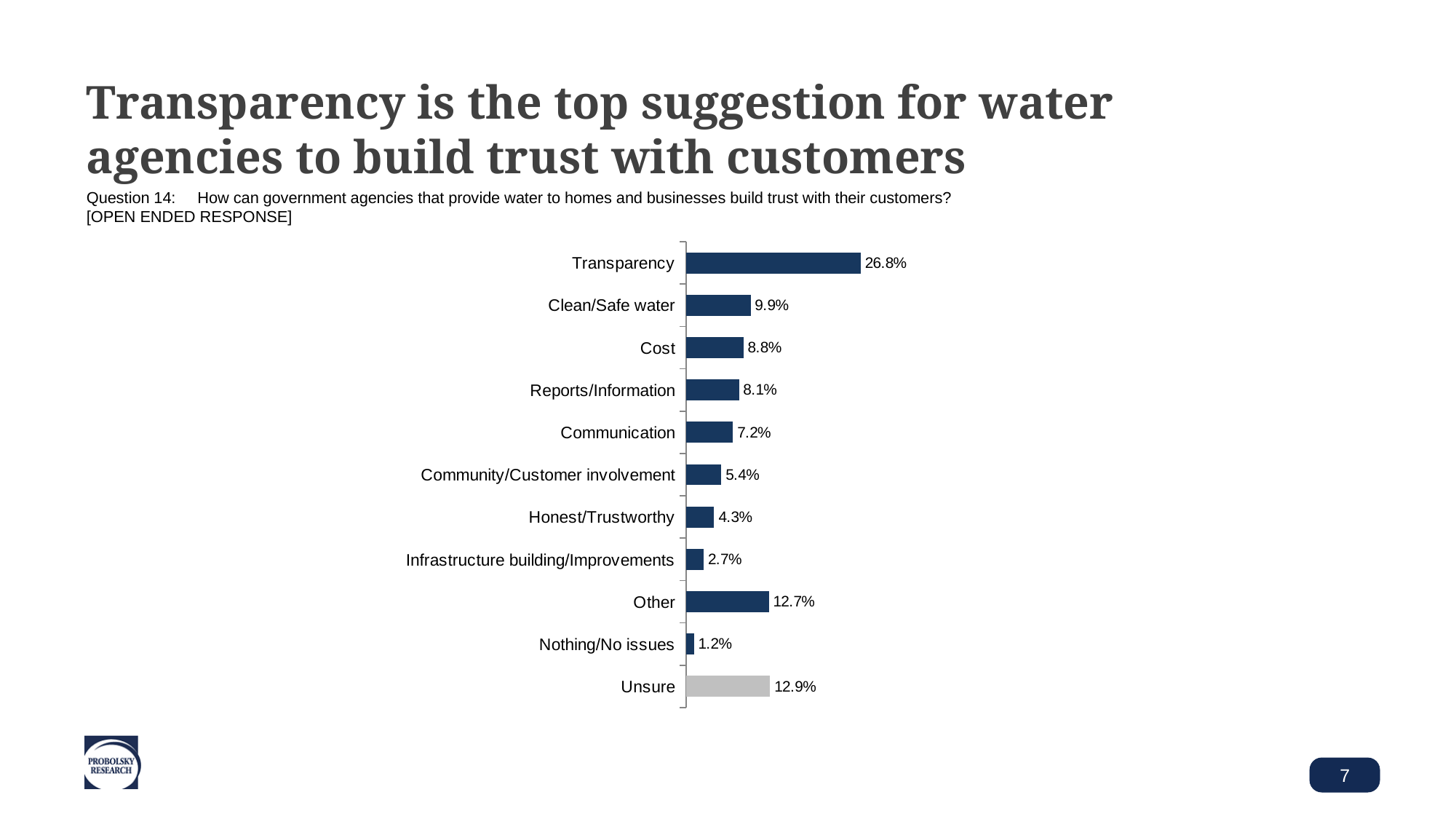
How many categories are shown in the chart? 11 Which category's bar is shown in grey rather than dark blue? Unsure What is the value for Community/Customer involvement? 5.4% What is the difference between the values for Transparency and Clean/Safe water? 16.9% What is the value for Transparency? 26.8% What is the value for Unsure? 12.9% What is the value for Clean/Safe water? 9.9% Which category has the highest value? Transparency What kind of chart is shown on the slide? Bar chart What is the difference between the values for Cost and Reports/Information? 0.7% Which category has the lowest value? Nothing/No issues Which is larger, the value for Communication or the value for Honest/Trustworthy? Communication